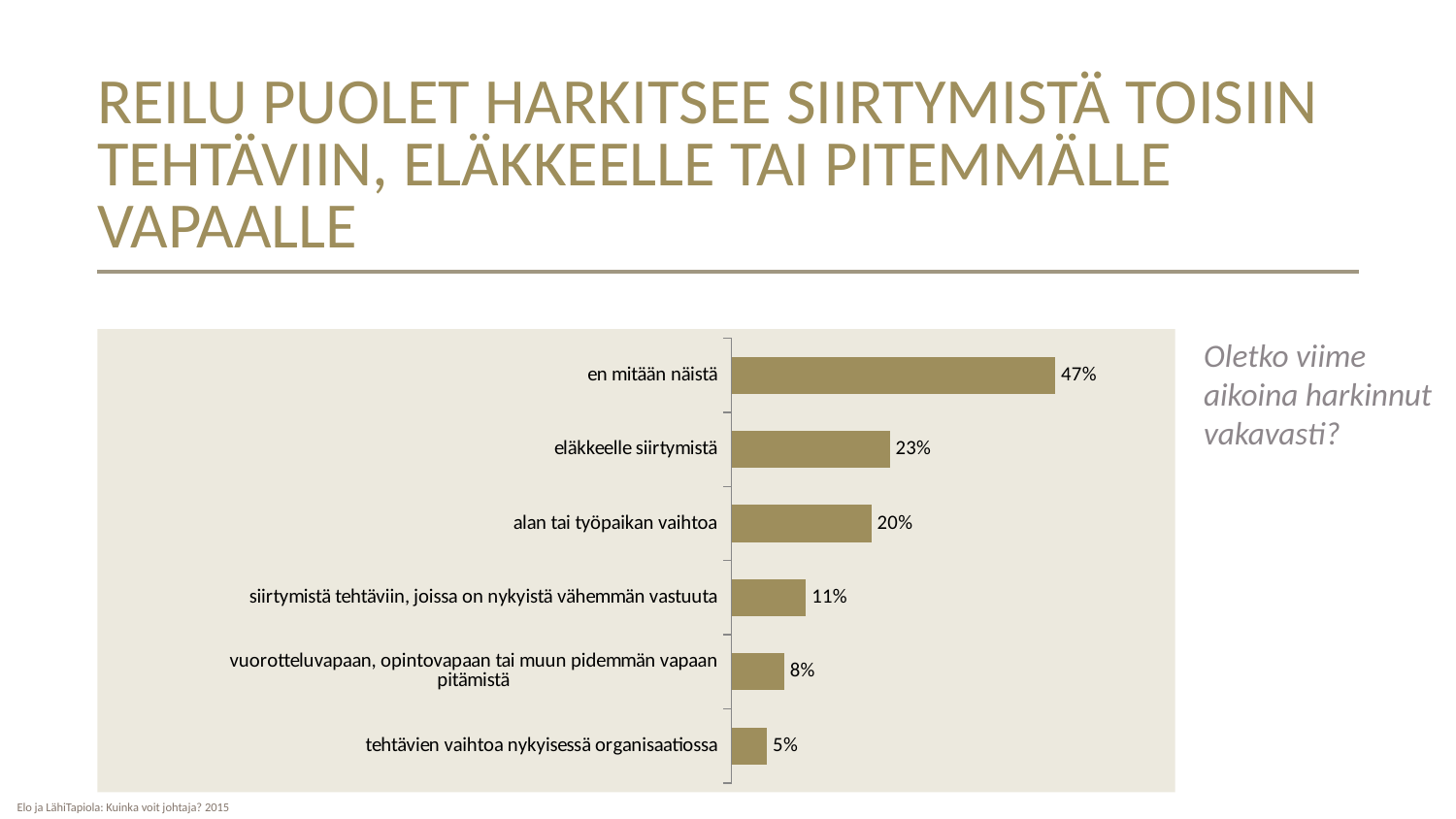
Which category has the lowest value? tehtävien vaihtoa nykyisessä organisaatiossa What is the value for "en mitään näistä"? 47% What is the value for "alan tai työpaikan vaihtoa"? 20% What kind of chart is shown on the slide? bar chart How many categories are shown in the chart? 6 What question is written in italics to the right of the chart? Oletko viime aikoina harkinnut vakavasti? What is the difference between the values for "en mitään näistä" and "tehtävien vaihtoa nykyisessä organisaatiossa"? 42% Which category has the highest value? en mitään näistä What is the value for "eläkkeelle siirtymistä"? 23% Which is larger: the value for "siirtymistä tehtäviin, joissa on nykyistä vähemmän vastuuta" or the value for "vuorotteluvapaan, opintovapaan tai muun pidemmän vapaan pitämistä"? siirtymistä tehtäviin, joissa on nykyistä vähemmän vastuuta What is the value for "tehtävien vaihtoa nykyisessä organisaatiossa"? 5% What is the difference between the values for "eläkkeelle siirtymistä" and "alan tai työpaikan vaihtoa"? 3%